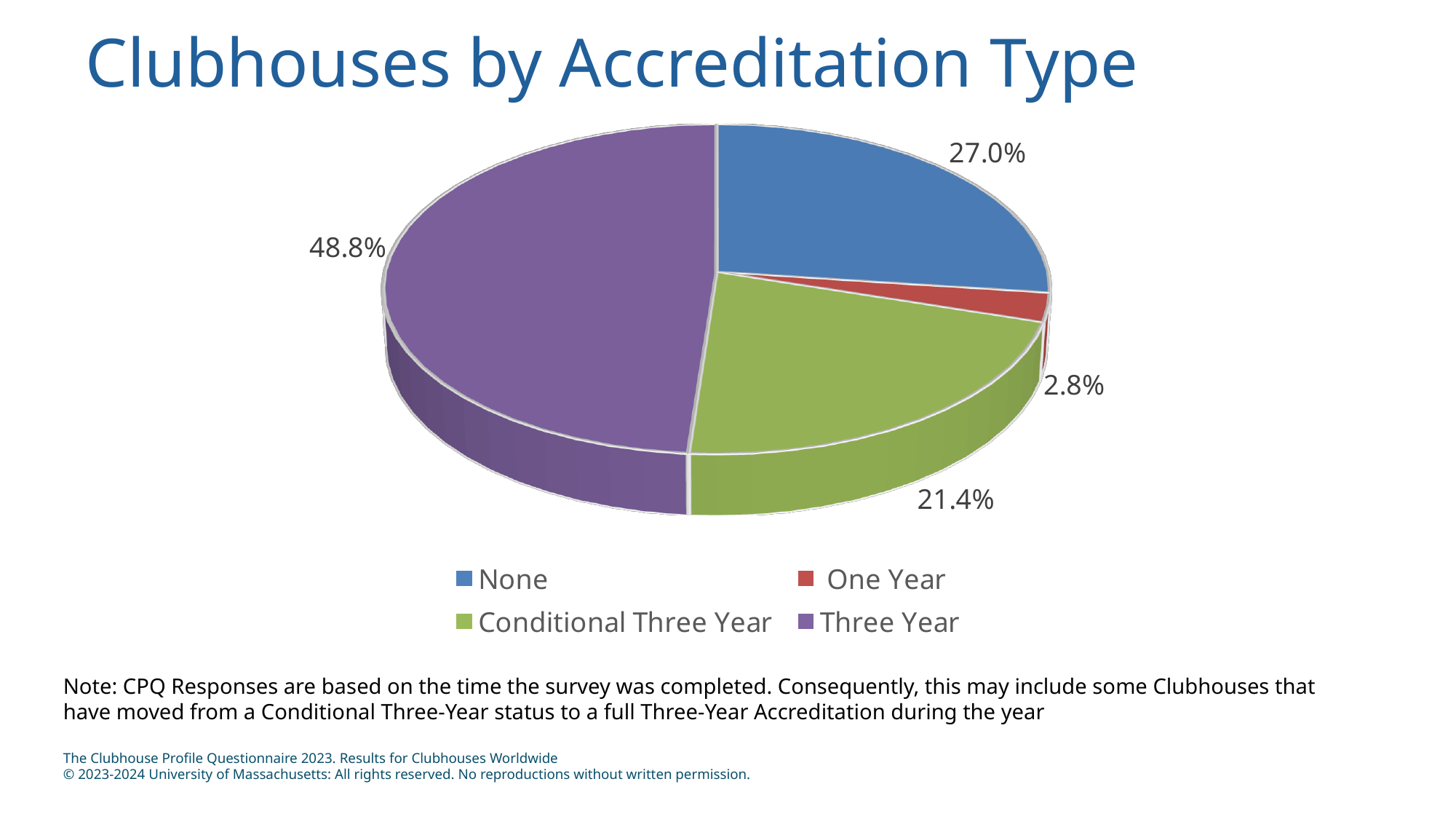
Which accreditation type has the largest share of clubhouses? Three Year What is the difference in percentage points between the Three Year and None slices? 21.8 Which is larger, the share for None or the share for Conditional Three Year? None What type of chart is shown on the slide? pie chart How many accreditation categories are shown in the pie chart? 4 What percentage of clubhouses have One Year accreditation? 2.8% What percentage of clubhouses have no accreditation (None)? 27.0% What is the title of the chart? Clubhouses by Accreditation Type What colour represents the Conditional Three Year slice? green What percentage of clubhouses have Conditional Three Year accreditation? 21.4% What percentage of clubhouses have Three Year accreditation? 48.8% Which accreditation type has the smallest share of clubhouses? One Year